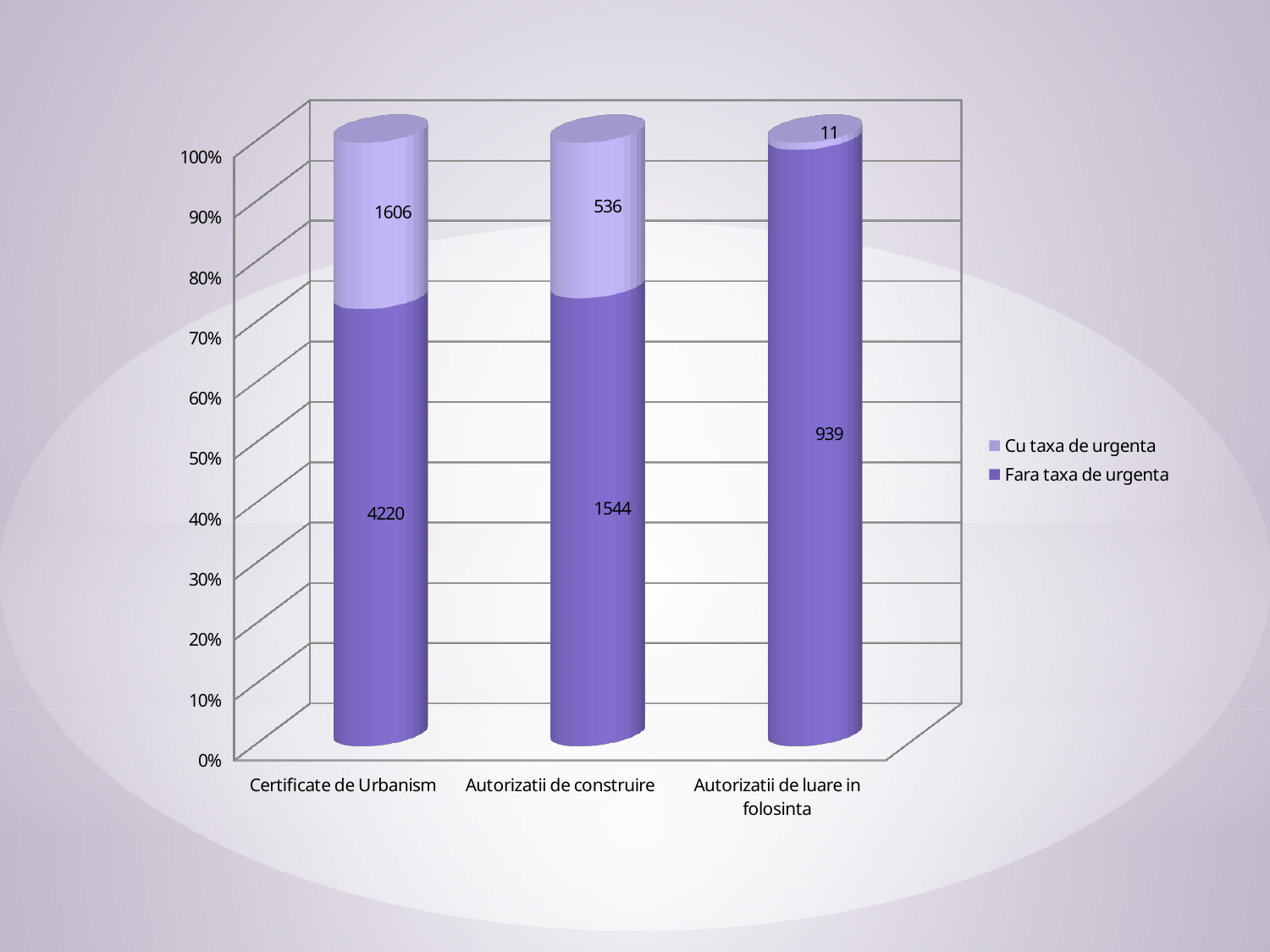
What is the difference between the Fara taxa de urgenta and Cu taxa de urgenta values for Autorizatii de construire? 1008 What is the value of Fara taxa de urgenta for Certificate de Urbanism? 4220 Which category has the highest value for Fara taxa de urgenta? Certificate de Urbanism What is the value of Fara taxa de urgenta for Autorizatii de luare in folosinta? 939 How many categories are shown on the x axis? 3 What is the total of the two series for Certificate de Urbanism? 5826 Which is larger: the Cu taxa de urgenta value for Certificate de Urbanism or for Autorizatii de construire? Certificate de Urbanism What is the value of Cu taxa de urgenta for Autorizatii de luare in folosinta? 11 Which category has the lowest value for Cu taxa de urgenta? Autorizatii de luare in folosinta What kind of chart is shown on the slide? Stacked bar chart What is the value of Cu taxa de urgenta for Autorizatii de construire? 536 How many series does the legend list? 2